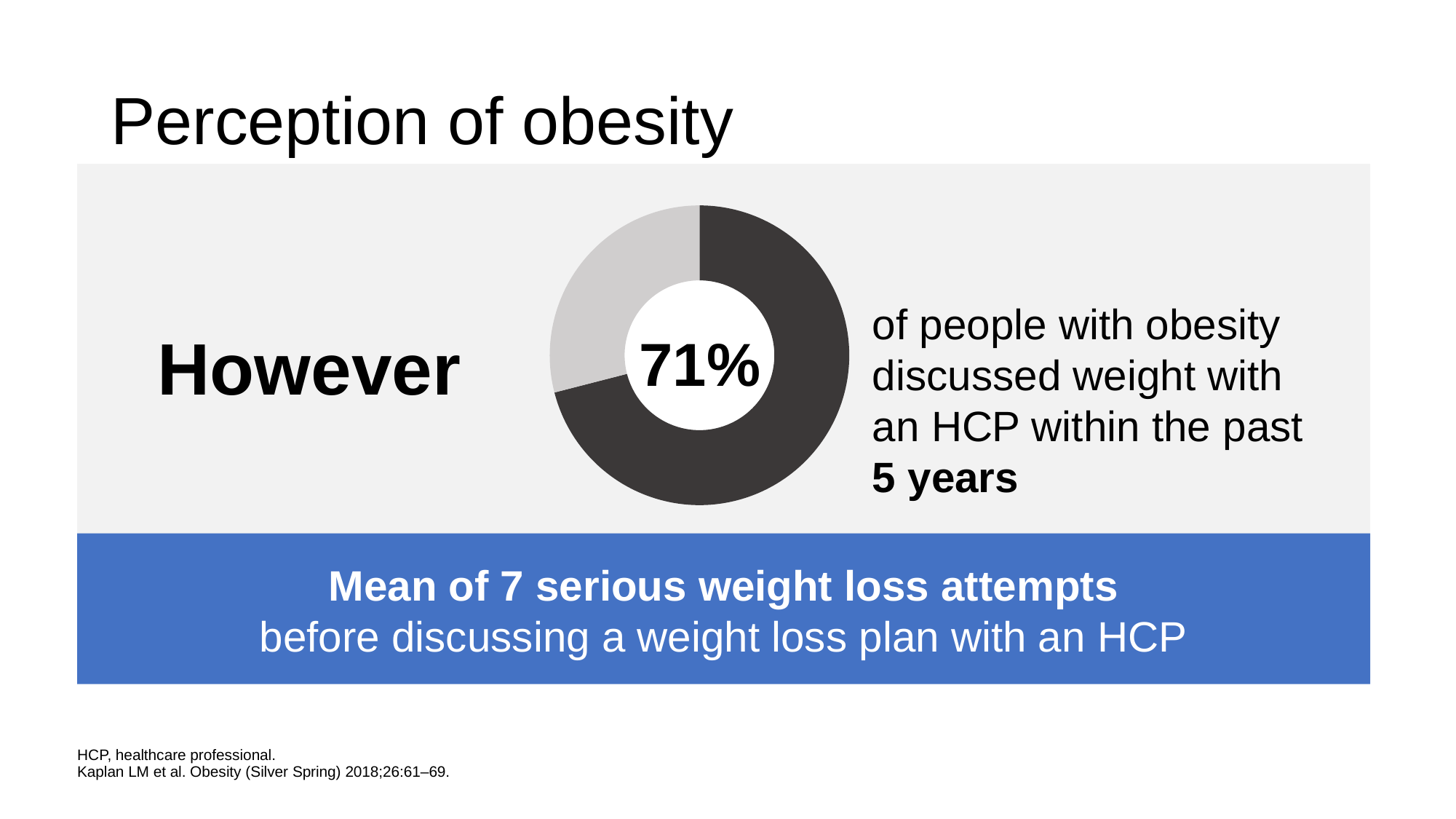
Which slice of the donut chart is larger, the dark grey one or the light grey one? the dark grey one What share of the donut chart does the light grey slice represent? 29% What percentage is printed in the centre of the donut chart? 71% What kind of chart is shown on the slide? pie chart (donut) Which slice of the donut chart is the largest? the dark grey slice (71%) Is the light grey slice of the donut chart greater or less than 50%? less What colour is the slice representing 71% in the donut chart? dark grey What does the 71% in the donut chart represent? people with obesity who discussed weight with an HCP within the past 5 years How many slices does the donut chart have? 2 Is the dark grey slice of the donut chart greater or less than 50%? greater